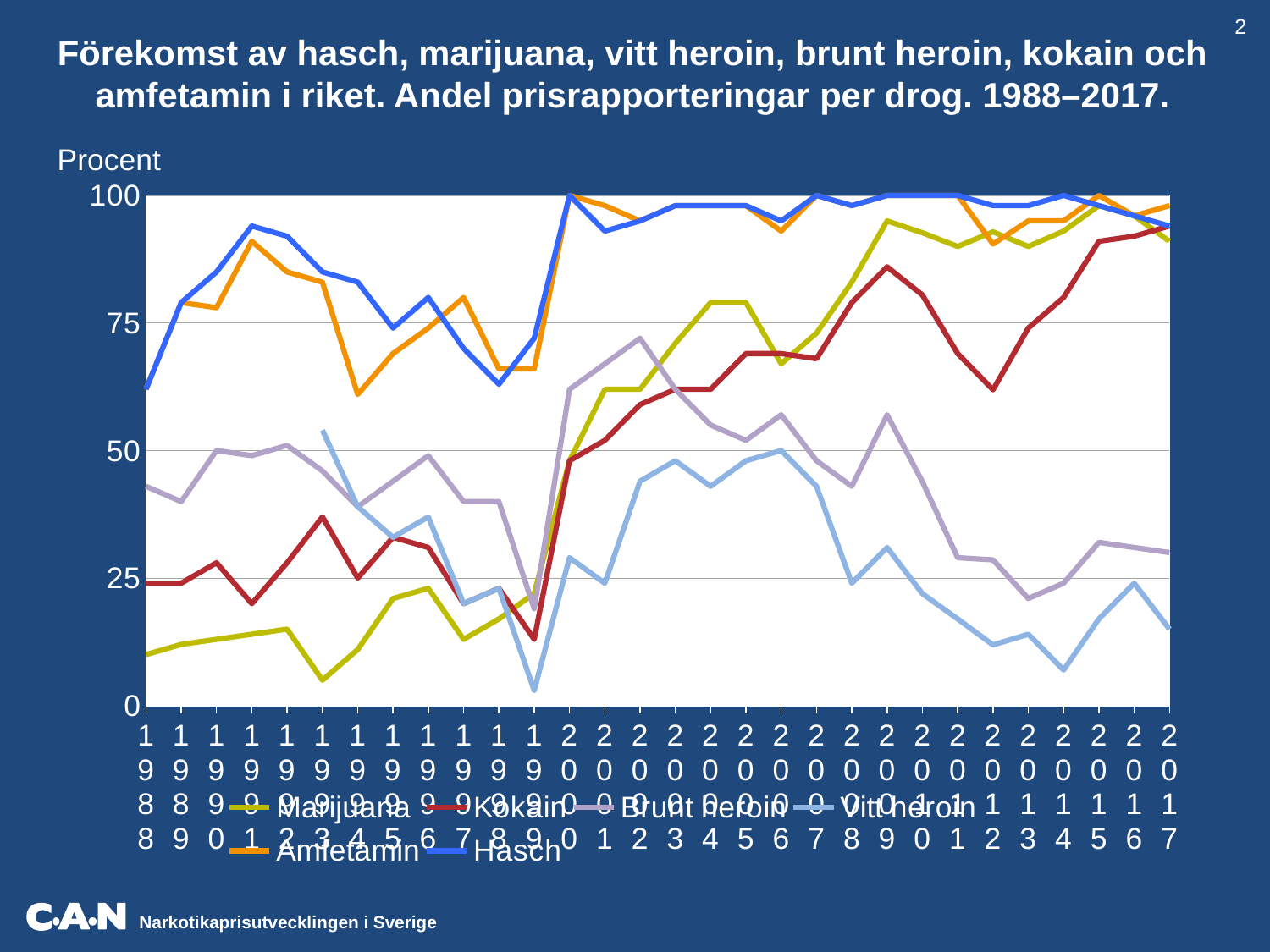
Which series has the lowest value in 1988? Marijuana What kind of chart is shown on the slide? Line chart Is the value for Hasch in 1988 greater or less than 50? greater Is the value for Vitt heroin in 2017 greater or less than 25? less Which series is shown with the orange line? Amfetamin Which series has the lowest value in 2017? Vitt heroin Does the Marijuana line overall rise or fall from 1988 to 2017? Rise Is the value for Kokain in 2017 greater or less than 75? greater How many series does the legend list? 6 How many years are plotted along the x axis? 30 What is the label on the y axis? Procent